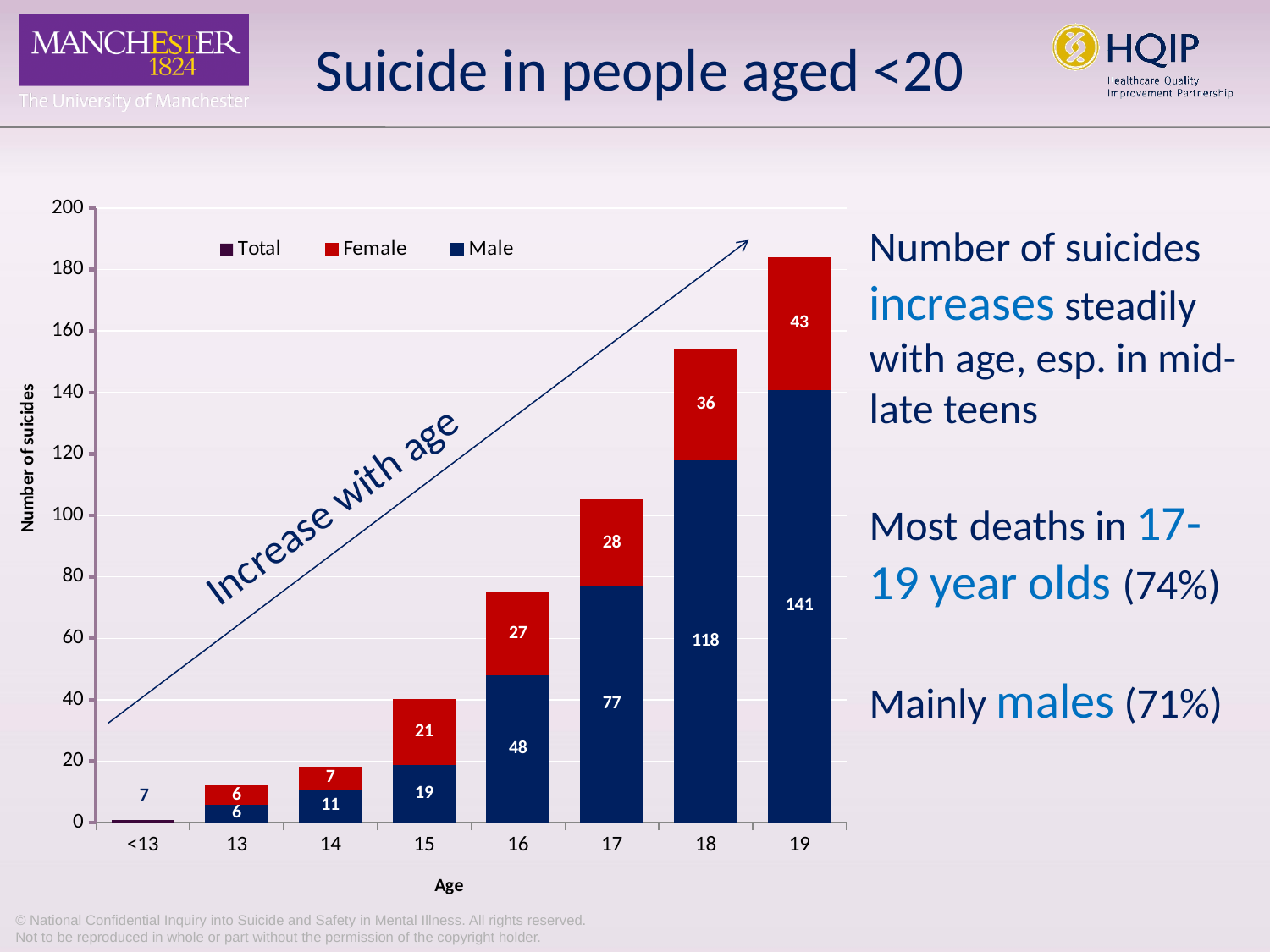
What is the Female value for age 16? 27 What is the Male value for age 19? 141 How many series does the legend list? 3 What is the total of the stacked bar for age 18 (Male plus Female)? 154 What is the difference between the Male values for age 18 and age 17? 41 What type of chart is shown on the slide? Stacked bar chart How many age categories are shown on the x axis? 8 What is the value shown for the <13 age group? 7 Which age group has the lowest Female value? 13 Which is larger, the Female value for age 15 or the Male value for age 15? Female (21) Do the bar totals rise or fall as age increases along the x axis? Rise Which age group has the highest Male value? 19